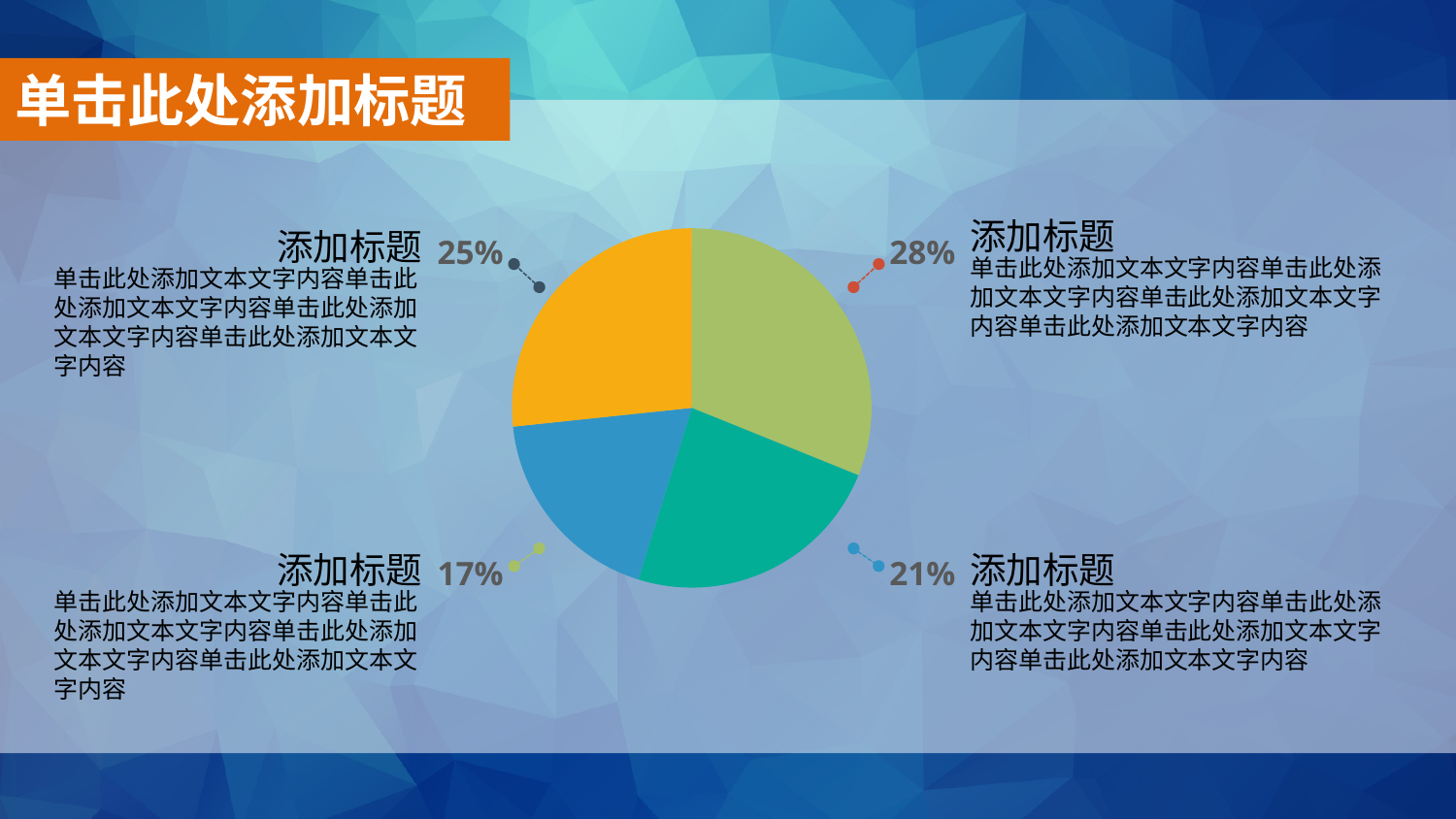
What percentage is labelled on the yellow-green slice at the top right of the pie chart? 28% Which percentage label on the pie chart is the smallest? 17% What is the difference between the orange slice's label and the teal slice's label? 4% Which percentage label on the pie chart is the largest? 28% What percentage is labelled on the teal slice at the bottom right of the pie chart? 21% How many slices does the pie chart have? 4 What percentage is labelled on the orange slice of the pie chart? 25% What is the difference between the largest and smallest percentage labels on the pie chart? 11% What kind of chart is shown on the slide? pie chart What percentage is labelled on the blue slice at the bottom left of the pie chart? 17% What colour is the slice labelled 28%? yellow-green Which slice is larger, the orange slice or the blue slice? the orange slice